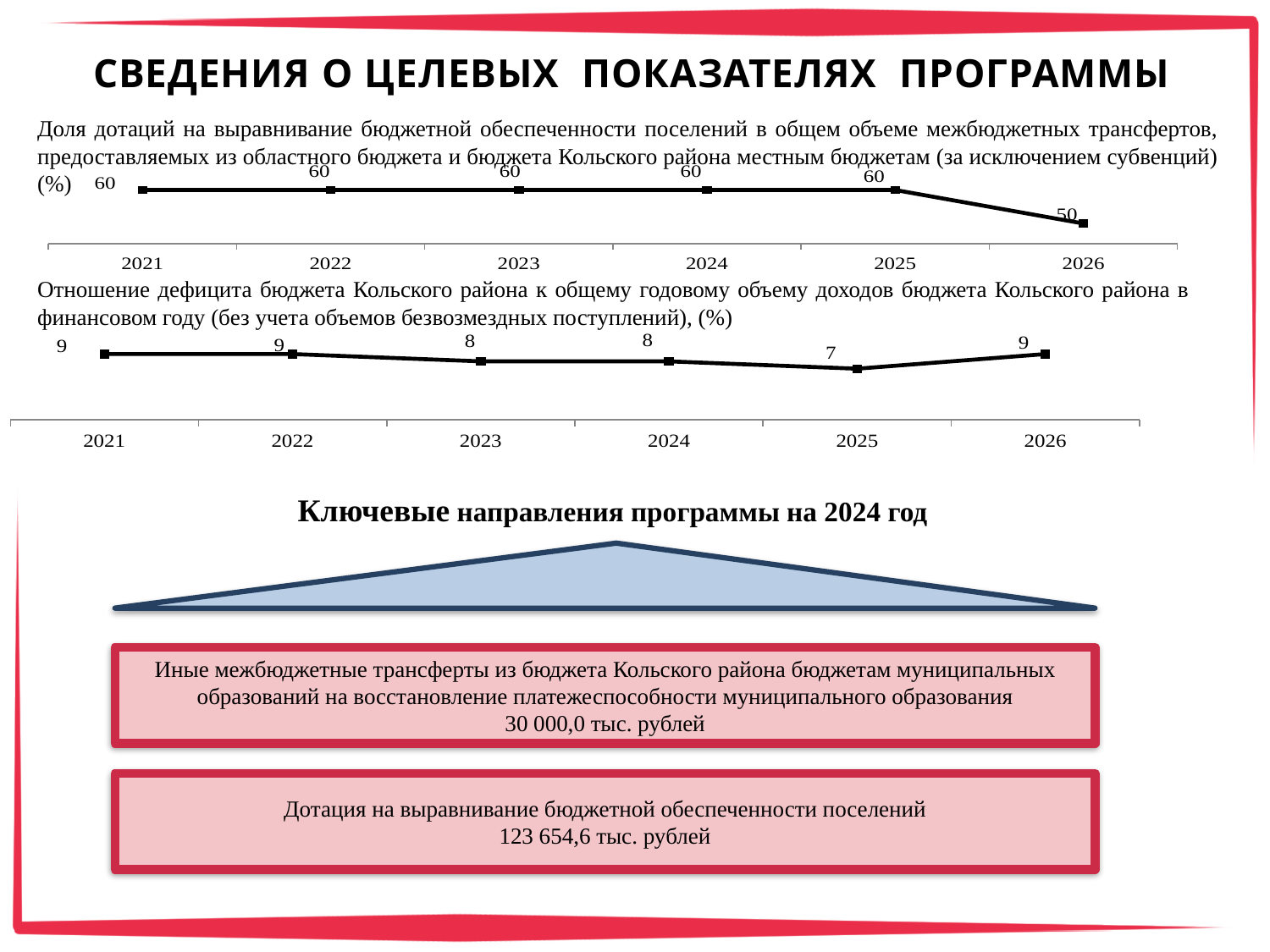
In the bottom chart (budget deficit ratio), what is the value for 2025? 7 In the top chart (share of equalization subsidies), which year has the lowest value? 2026 In the bottom chart (budget deficit ratio), which is larger: the value for 2022 or the value for 2025? 2022 In the top chart (share of equalization subsidies), what is the value for 2026? 50 In the top chart (share of equalization subsidies), how many years are plotted? 6 In the bottom chart (budget deficit ratio), what is the value for 2023? 8 In the top chart (share of equalization subsidies), what is the value for 2021? 60 In the top chart (share of equalization subsidies), what is the difference between the 2025 and 2026 values? 10 In the bottom chart (budget deficit ratio), does the value rise or fall from 2025 to 2026? Rise In the bottom chart (budget deficit ratio), which year has the lowest value? 2025 In the bottom chart (budget deficit ratio), what is the difference between the 2021 and 2025 values? 2 What type of chart is the top chart (share of equalization subsidies)? Line chart